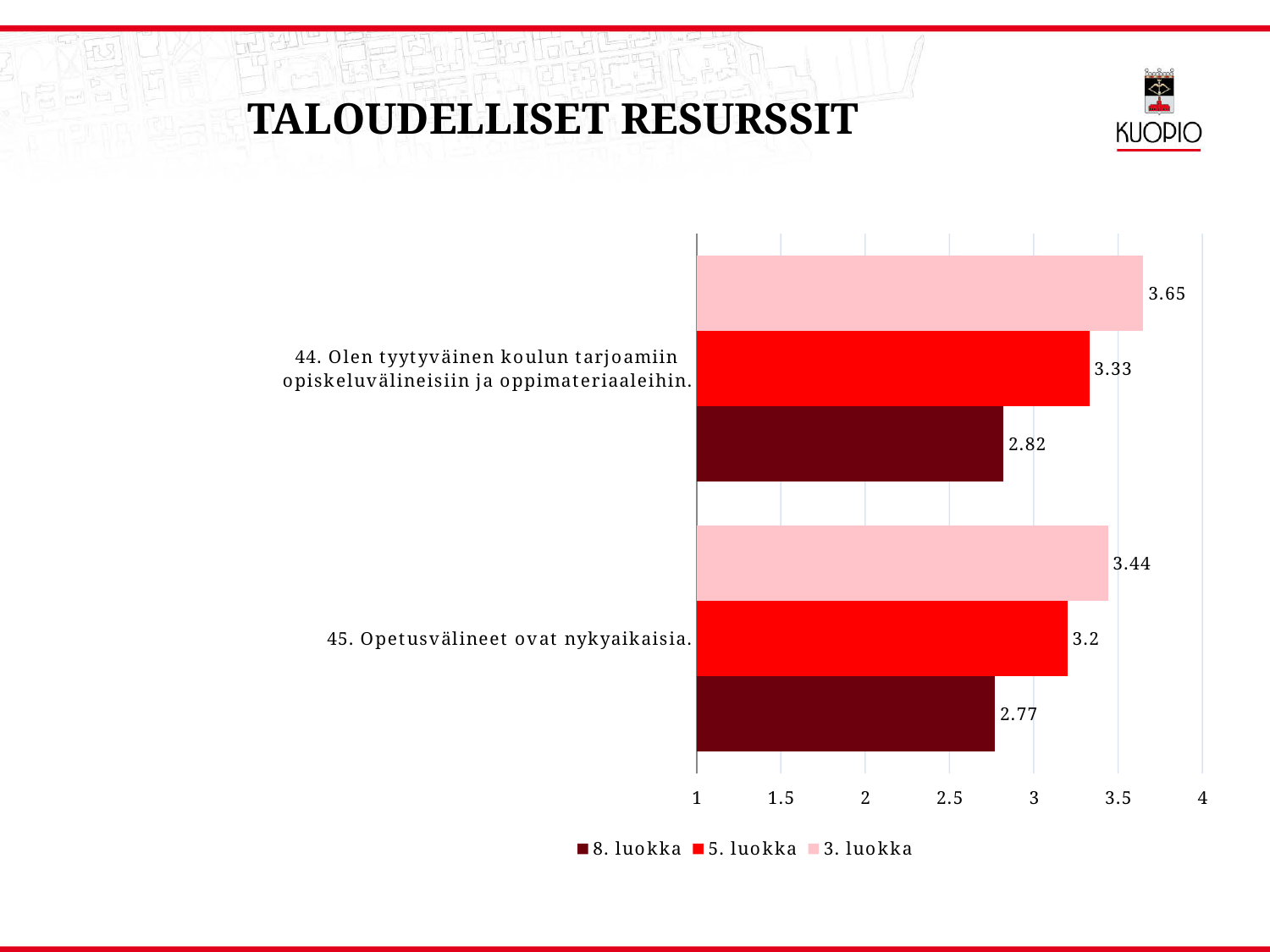
What is the value for 3. luokka on statement 44 (Olen tyytyväinen koulun tarjoamiin opiskeluvälineisiin ja oppimateriaaleihin)? 3.65 Is the value for 3. luokka on statement 45 greater or less than 3.5? less Which is larger: the 8. luokka value on statement 44 or on statement 45? Statement 44 (2.82) What kind of chart is shown on the slide? Bar chart How many statements (categories) are shown on the chart? 2 Which series has the lowest value on statement 45? 8. luokka What is the value for 5. luokka on statement 45 (Opetusvälineet ovat nykyaikaisia)? 3.2 Which series has the highest value on statement 44? 3. luokka What is the value for 8. luokka on statement 45 (Opetusvälineet ovat nykyaikaisia)? 2.77 What is the difference between the 3. luokka and 8. luokka values on statement 44? 0.83 How many series does the legend list? 3 What is the difference between the 5. luokka values for statement 44 and statement 45? 0.13